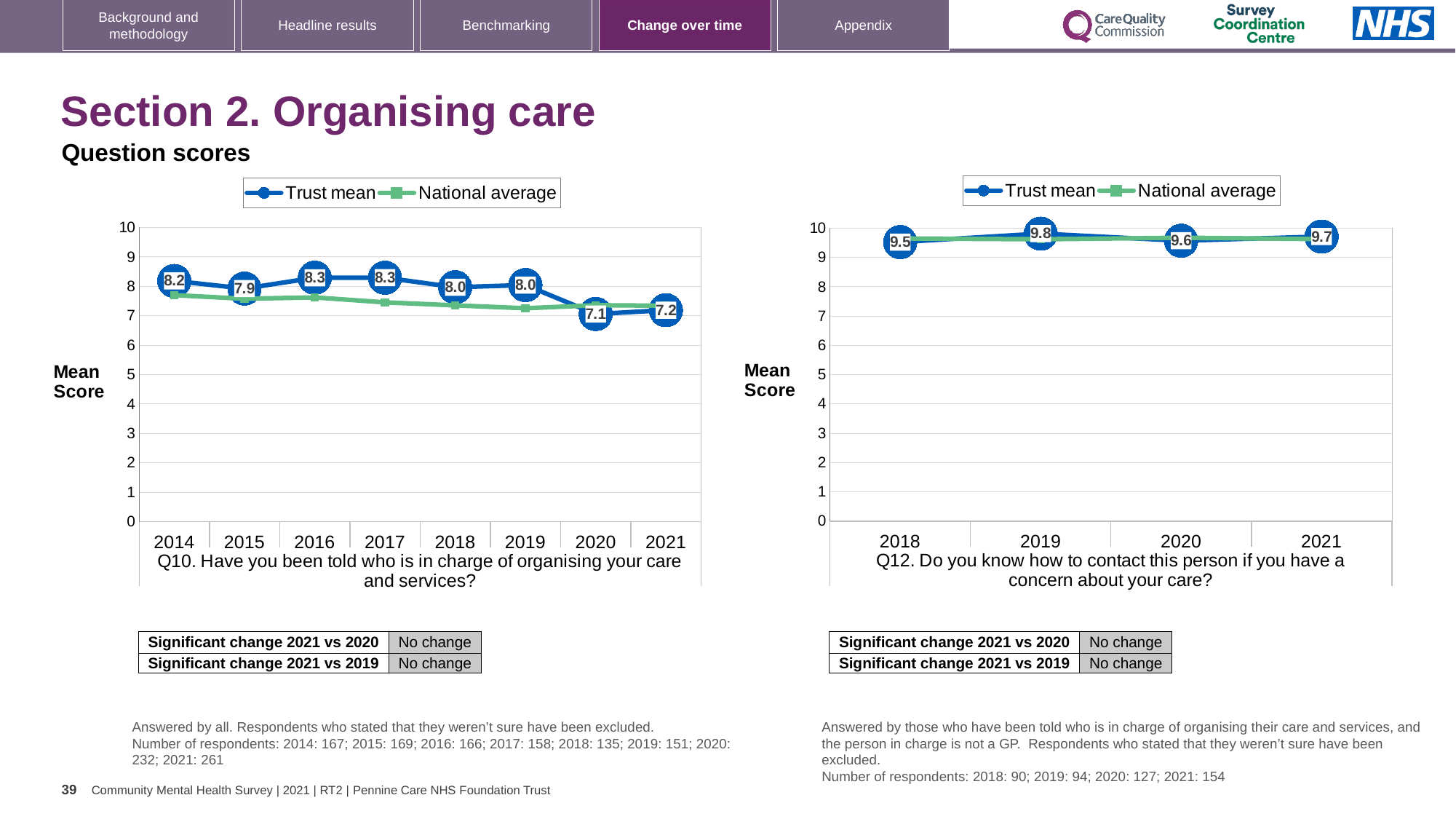
What type of chart is the Q10 chart on the left? Line chart In the Q10 chart on the left, is the National average for 2014 greater or less than 7? greater How many series does the legend of the Q12 chart on the right list? 2 In the Q10 chart on the left, which year has the lowest Trust mean? 2020 In the Q10 chart on the left, is the Trust mean higher in 2015 or in 2019? 2019 In the Q12 chart on the right, what is the difference between the Trust mean in 2019 and in 2018? 0.3 In the Q10 chart on the left, what is the Trust mean for 2016? 8.3 In the Q10 chart on the left, what is the Trust mean for 2020? 7.1 In the Q12 chart on the right, which year has the highest Trust mean? 2019 In the Q10 chart on the left, what is the difference between the Trust mean in 2014 and in 2021? 1.0 In the Q12 chart on the right, what is the Trust mean for 2019? 9.8 How many years are shown on the x axis of the Q10 chart on the left? 8